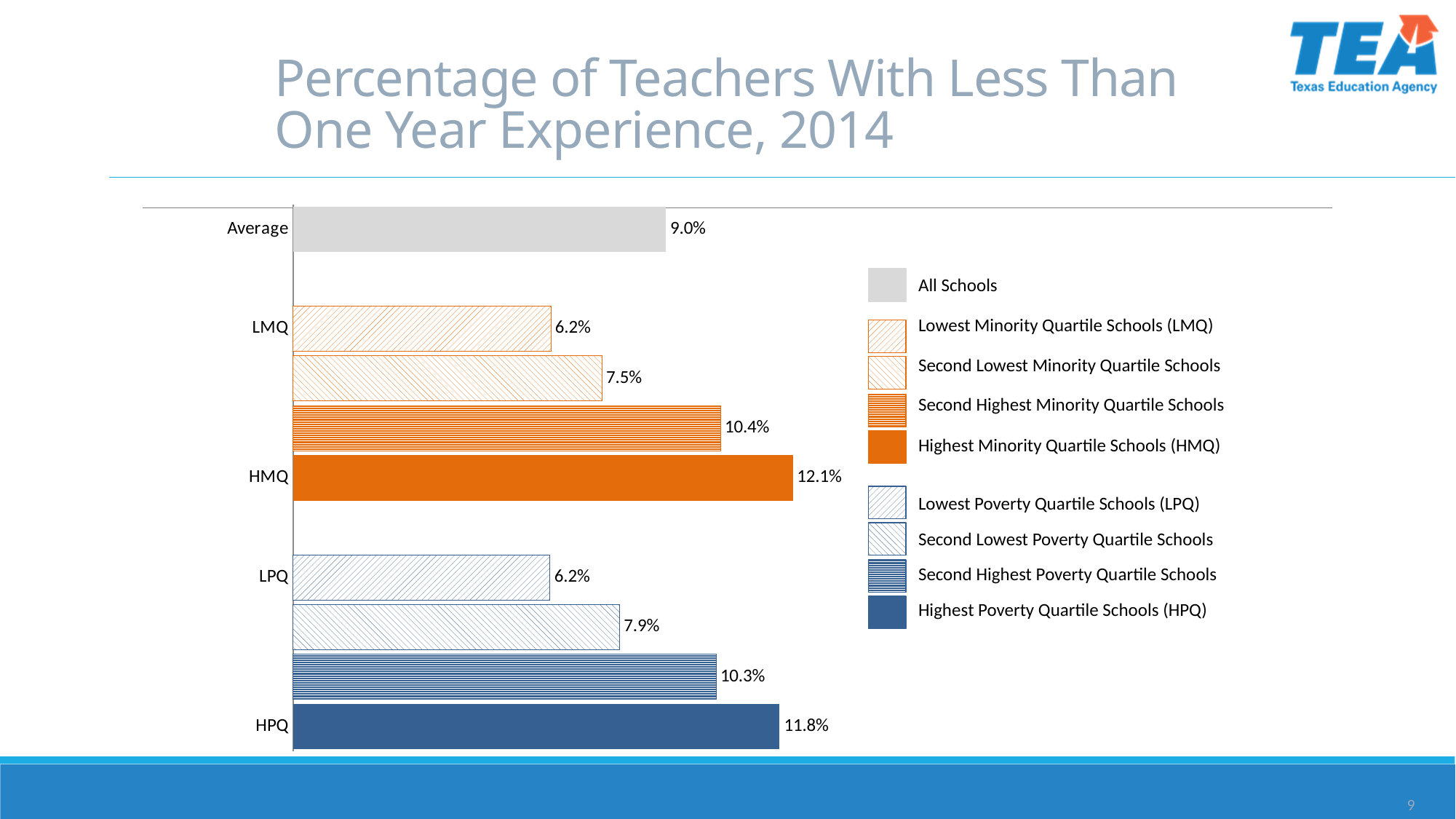
What is the value for Highest Poverty Quartile Schools (HPQ)? 11.8% What kind of chart is shown on the slide? Bar chart How many entries does the legend list? 9 What is the value for Highest Minority Quartile Schools (HMQ)? 12.1% What is the value for Average (All Schools)? 9.0% What is the value for Second Highest Minority Quartile Schools? 10.4% How many bars are plotted on the chart? 9 What is the value for Second Lowest Poverty Quartile Schools? 7.9% Which bar has the highest value? Highest Minority Quartile Schools (HMQ) Which is larger, the value for Second Lowest Minority Quartile Schools or Second Lowest Poverty Quartile Schools? Second Lowest Poverty Quartile Schools What is the difference between the Second Highest Poverty Quartile Schools value and the Average value? 1.3% What is the difference between the HMQ value and the HPQ value? 0.3%